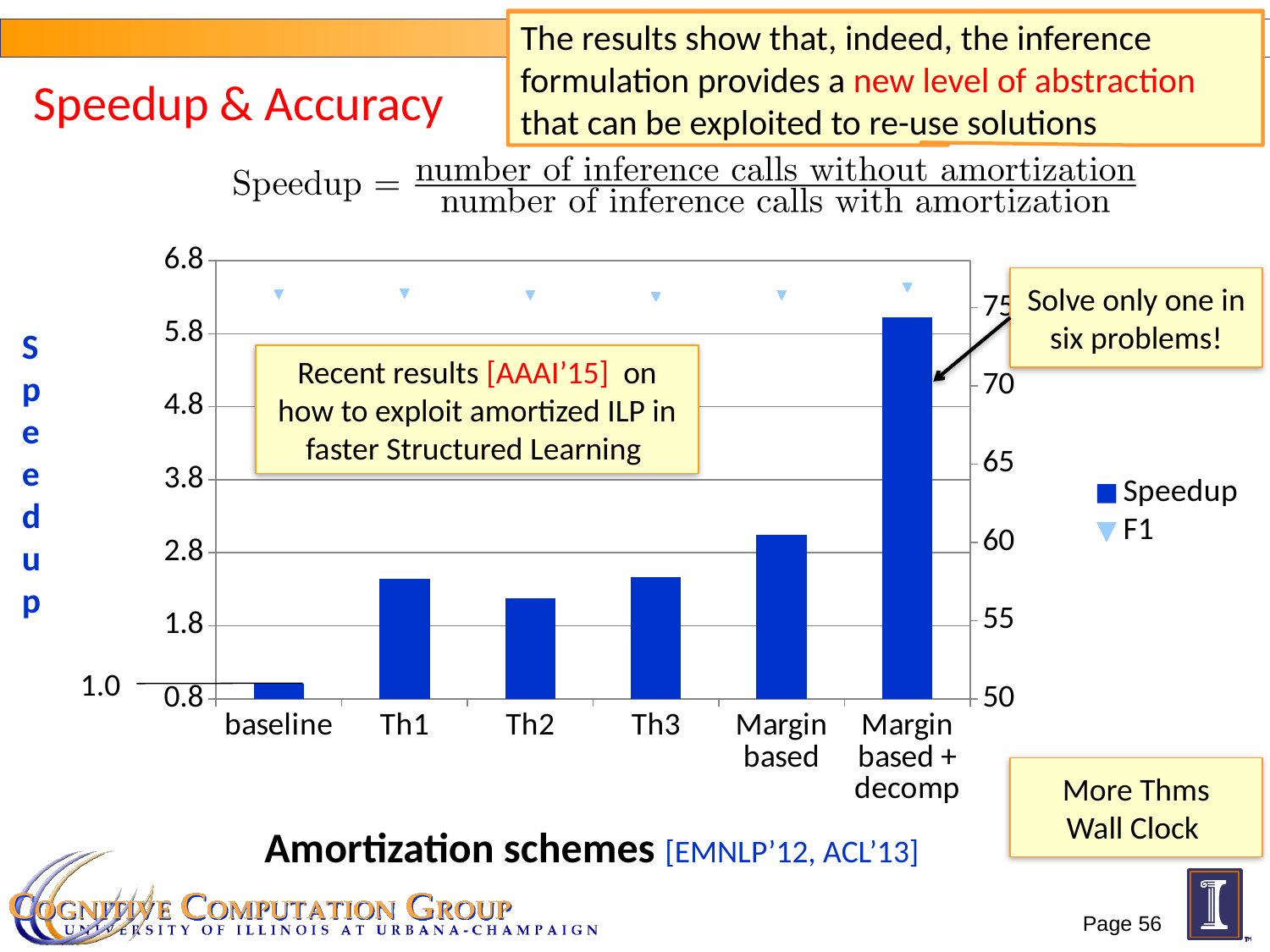
Is the Speedup value for Margin based + decomp greater or less than 4.8? greater Which amortization scheme has the highest Speedup bar? Margin based + decomp Is the Speedup value for Th1 greater or less than 2.8? less What is the title of the chart's x axis? Amortization schemes How many series does the chart's legend list? 2 Is the Speedup value for Th2 greater or less than 1.8? greater What are the two series named in the chart's legend? Speedup and F1 Which amortization scheme has the lowest Speedup bar? baseline How many amortization schemes (categories) are shown on the x axis of the chart? 6 What kind of chart is shown on the slide? bar chart Which has the larger Speedup, Margin based or Th1? Margin based